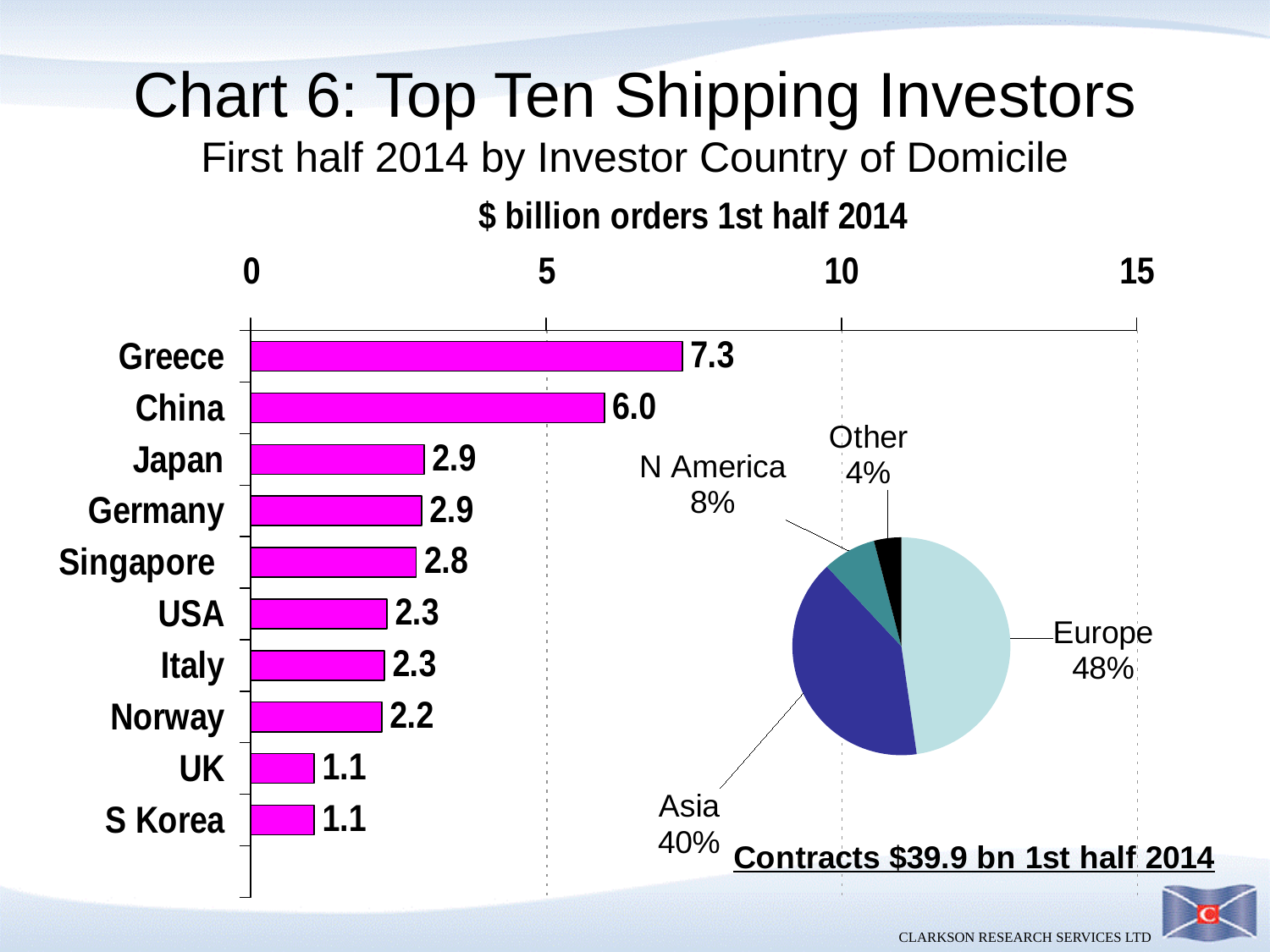
How many countries are shown in the bar chart? 10 How many slices does the pie chart have? 4 In the bar chart, what is the value for Greece? 7.3 In the bar chart, is the value for Greece greater or less than 5? greater In the pie chart, which region has the smallest share? Other In the pie chart, what share does Asia have? 40% What kind of chart is the chart on the left of the slide? bar chart In the bar chart, what is the value for Singapore? 2.8 In the bar chart, what is the difference between the values for Greece and China? 1.3 In the bar chart, which is larger, the value for China or the value for Japan? China In the bar chart, which country has the highest value? Greece In the pie chart, what share does Europe have? 48%